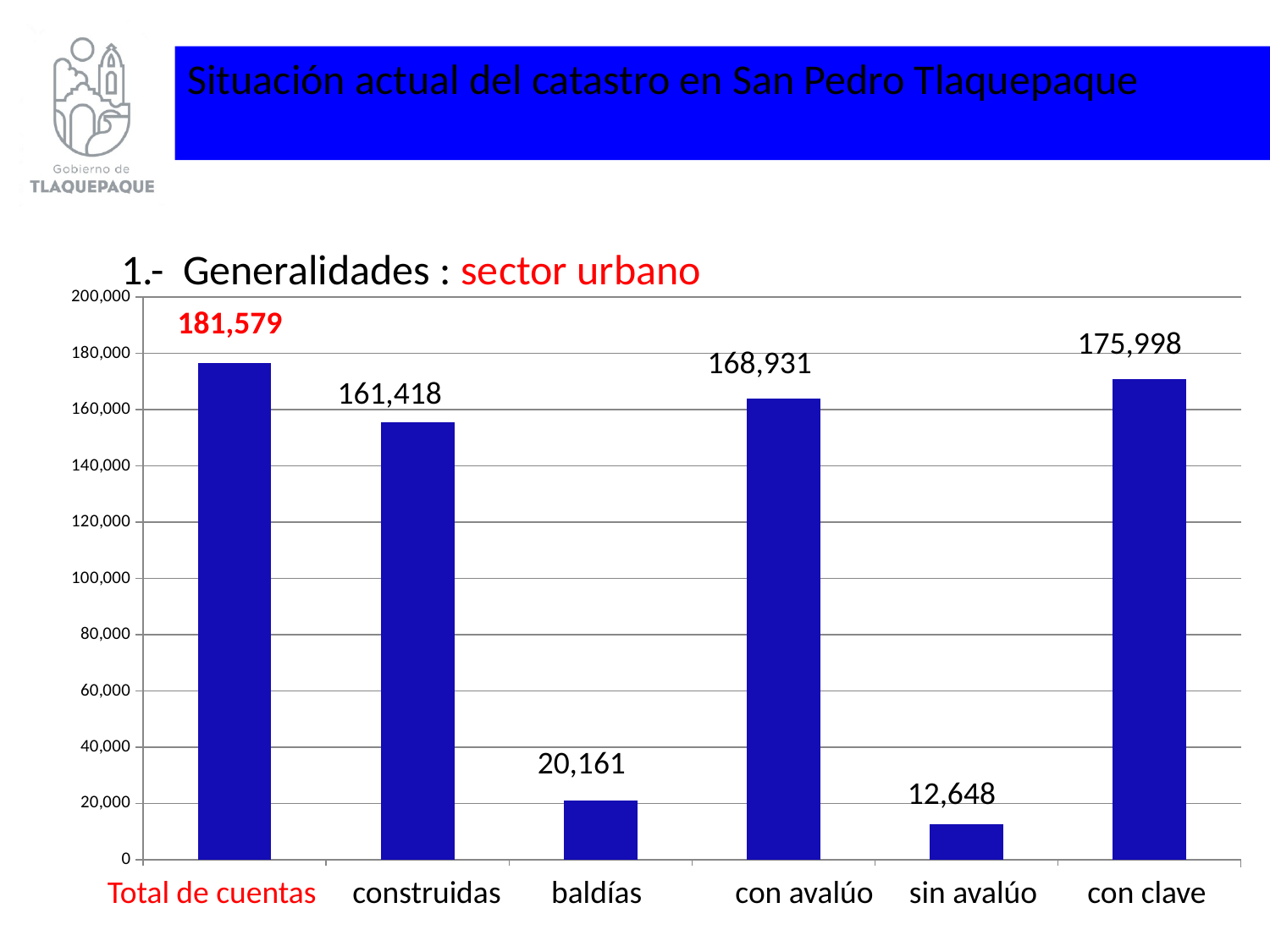
What is the value for 'construidas'? 161,418 Which is larger, 'con avalúo' or 'construidas'? con avalúo Which category has the lowest value? sin avalúo What is the value for 'con clave'? 175,998 How many categories are shown on the x axis? 6 What is the value for 'sin avalúo'? 12,648 What is the value for 'Total de cuentas'? 181,579 What is the difference between 'Total de cuentas' and 'con clave'? 5,581 Which category has the highest value? Total de cuentas Which category label on the x axis is written in red? Total de cuentas What kind of chart is shown on the slide? bar chart What is the difference between 'baldías' and 'sin avalúo'? 7,513